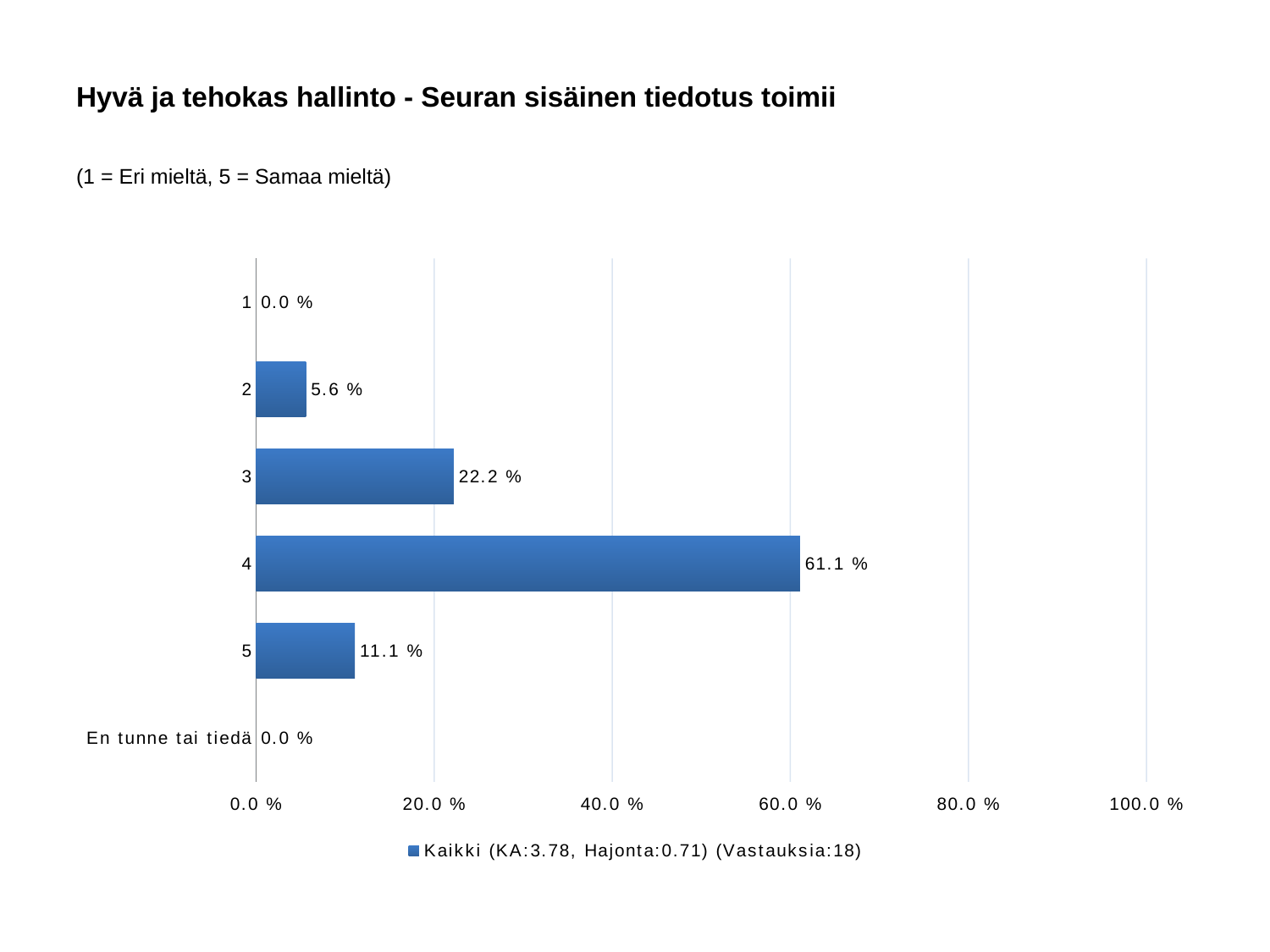
What is the value for category 3? 22.2 % How many responses (Vastauksia) does the legend report? 18 What is the difference between the values for category 4 and category 3? 38.9 % Which category has the highest value? 4 What is the value for category 5? 11.1 % How many categories are shown on the chart? 6 What is the value for 'En tunne tai tiedä'? 0.0 % What is the value for category 4? 61.1 % Which is larger, the value for category 3 or the value for category 5? 3 What is the value for category 2? 5.6 % What kind of chart is shown on the slide? bar chart Is the value for category 4 greater or less than 60.0 %? greater